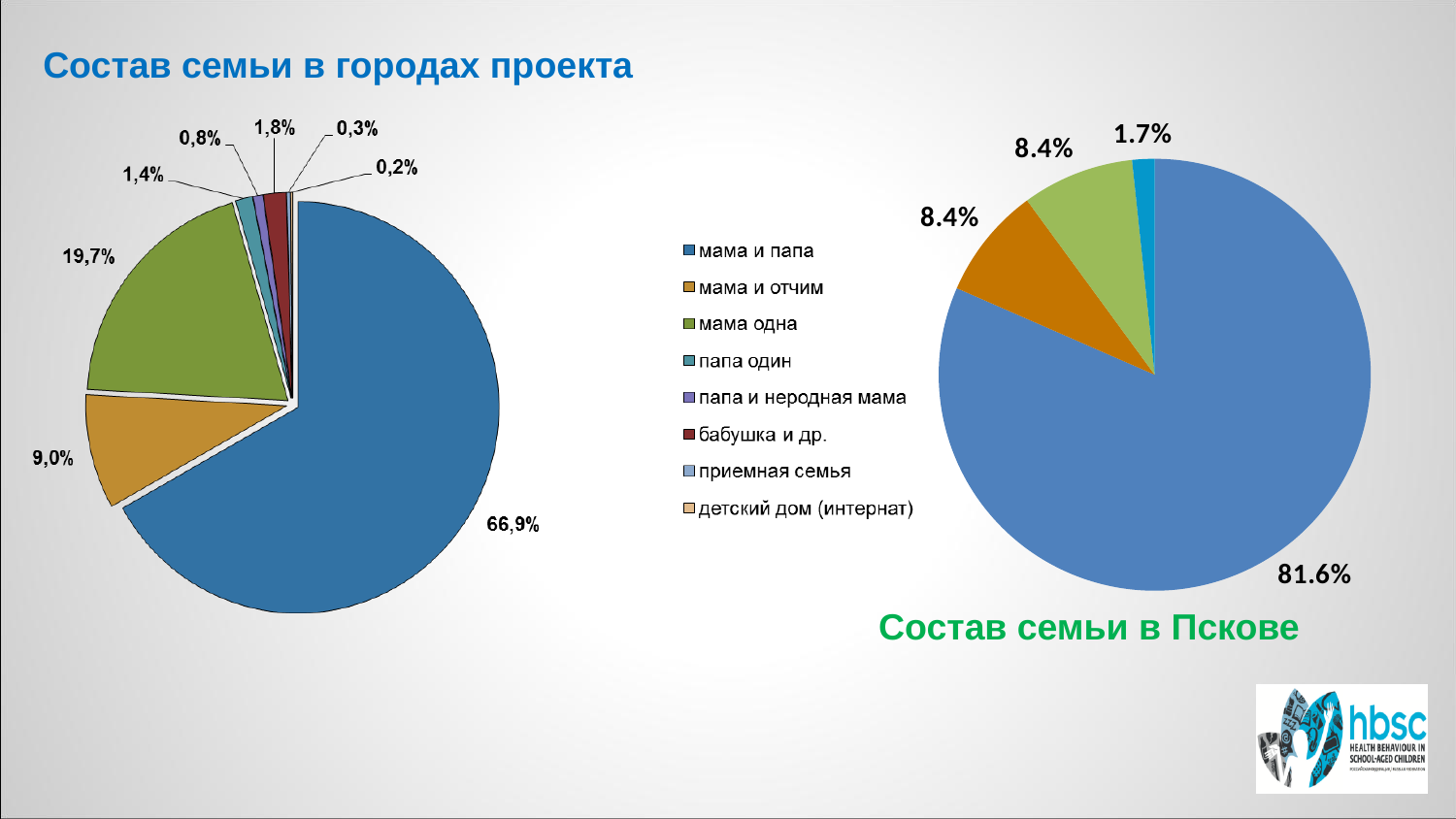
What kind of chart is used for 'Состав семьи в городах проекта'? pie chart In the 'Состав семьи в городах проекта' chart, what share is labelled for 'мама и отчим'? 9,0% In the 'Состав семьи в Пскове' chart, what is the smallest labelled share? 1.7% In the 'Состав семьи в городах проекта' chart, which category has the largest slice? мама и папа In the 'Состав семьи в городах проекта' chart, what share is labelled for 'мама и папа'? 66,9% In the 'Состав семьи в городах проекта' chart, which category has the smallest slice? детский дом (интернат) In the 'Состав семьи в городах проекта' chart, what share is labelled for 'мама одна'? 19,7% In the 'Состав семьи в городах проекта' chart, what is the difference between the shares for 'мама одна' and 'мама и отчим'? 10,7% In the 'Состав семьи в Пскове' chart, how many slices are there? 4 How many categories does the legend list for the family composition charts? 8 In the 'Состав семьи в Пскове' chart, what share is labelled for the largest slice? 81.6% Which is larger: the 'мама и папа' share in 'Состав семьи в городах проекта' (66,9%) or the largest slice in 'Состав семьи в Пскове' (81.6%)? Состав семьи в Пскове (81.6%)